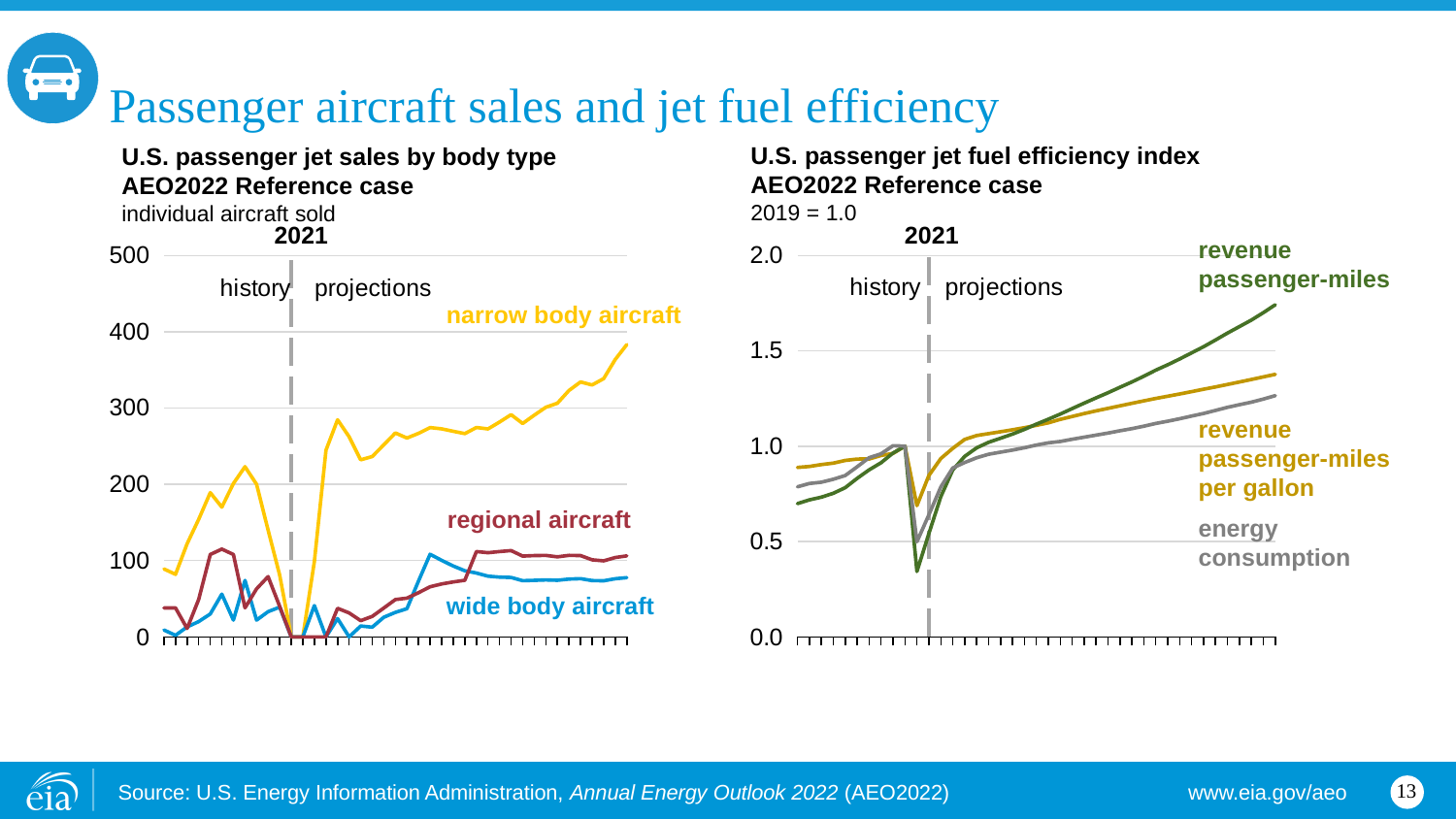
How many series are plotted on the 'U.S. passenger jet sales by body type' chart? 3 What kind of chart is the 'U.S. passenger jet sales by body type' chart on the left? line chart What year marks the boundary between history and projections on both charts? 2021 How many series are plotted on the 'U.S. passenger jet fuel efficiency index' chart? 3 On the 'U.S. passenger jet fuel efficiency index' chart, is the value for revenue passenger-miles at the end of the projections greater or less than 1.5? greater On the 'U.S. passenger jet sales by body type' chart, is the value for narrow body aircraft at the end of the projections greater or less than 300? greater On the 'U.S. passenger jet sales by body type' chart, which series has the highest value at the end of the projection period? narrow body aircraft On the 'U.S. passenger jet sales by body type' chart, at the end of the projections, which is larger: regional aircraft or wide body aircraft? regional aircraft On the 'U.S. passenger jet sales by body type' chart, is the value for wide body aircraft at the end of the projections greater or less than 100? less On the 'U.S. passenger jet fuel efficiency index' chart, which series has the highest value at the end of the projection period? revenue passenger-miles On the 'U.S. passenger jet sales by body type' chart, do narrow body aircraft sales generally rise or fall over the projection period? rise